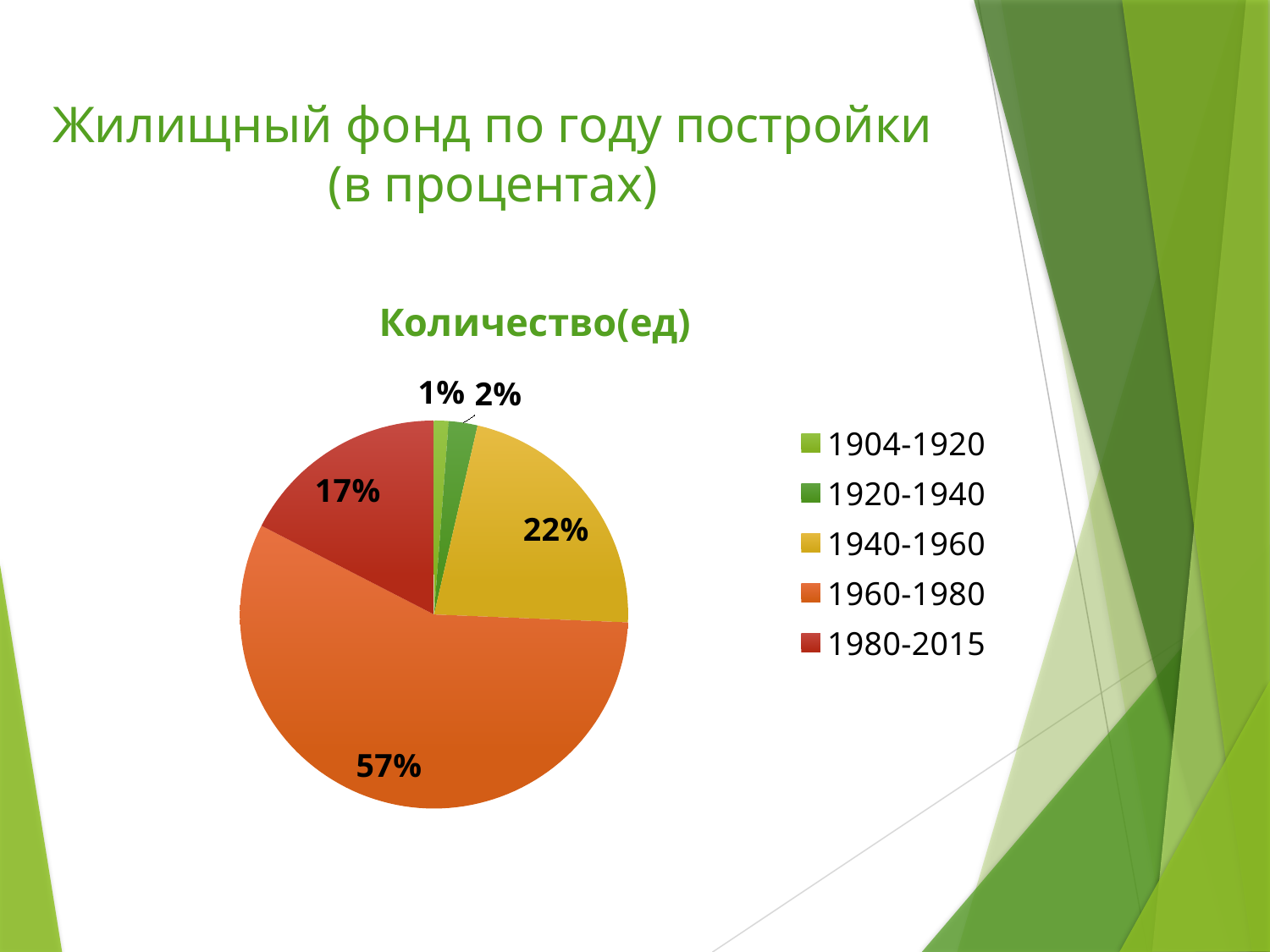
What share of the pie does the 1920-1940 slice have? 2% How many categories does the legend list? 5 What is the difference between the 1960-1980 share and the 1940-1960 share? 35% What is the chart's title? Количество(ед) What share of the pie does the 1980-2015 slice have? 17% What share of the pie does the 1960-1980 slice have? 57% Which category has the smallest slice? 1904-1920 Which is larger, the 1940-1960 slice or the 1980-2015 slice? 1940-1960 What kind of chart is shown on the slide? pie chart Which category has the largest slice? 1960-1980